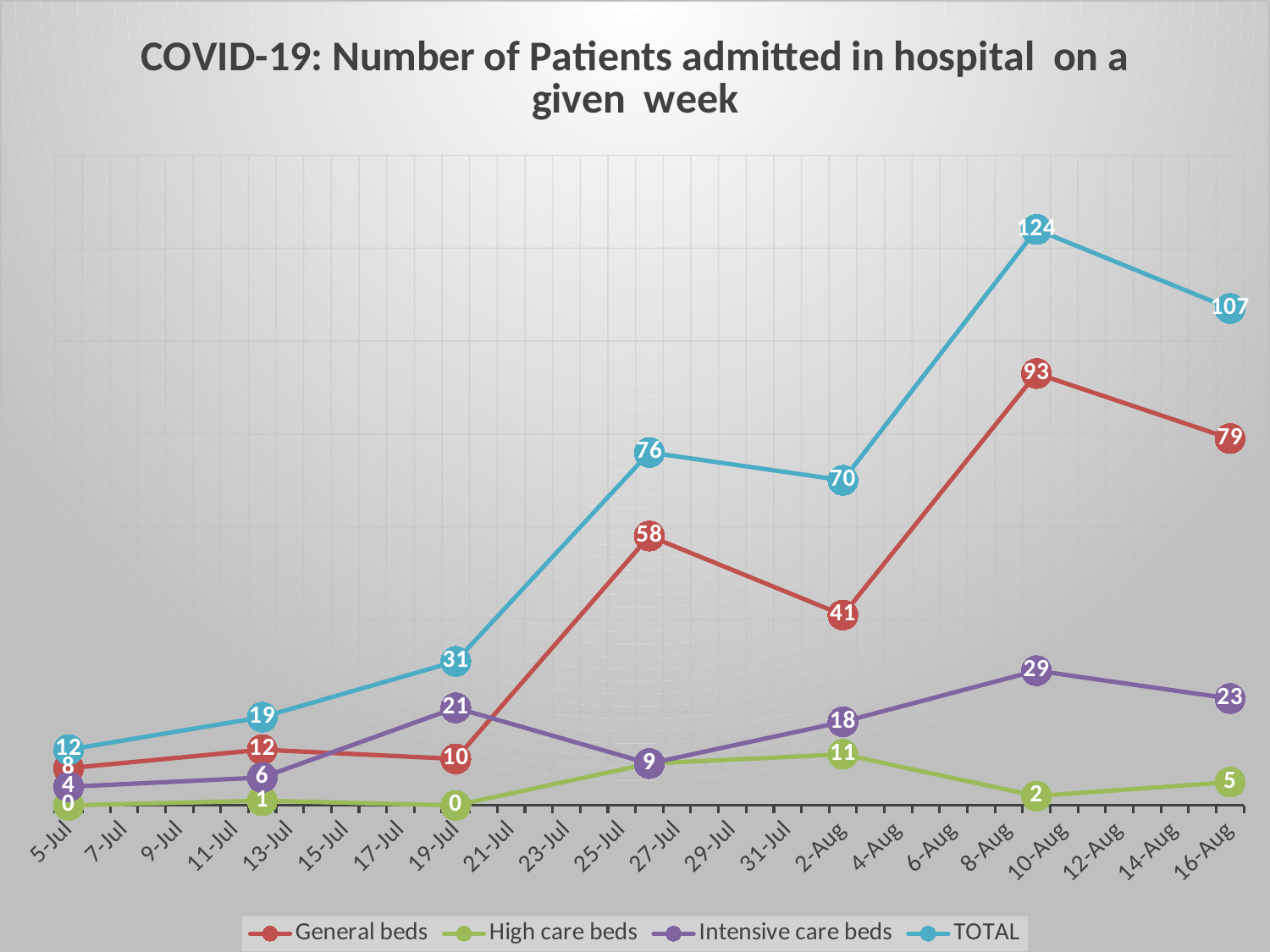
How many data points does the TOTAL series have? 7 What is the difference between the TOTAL value and the General beds value on 16-Aug? 28 On 2-Aug, which is larger: Intensive care beds or High care beds? Intensive care beds What type of chart is shown on the slide? line chart What is the General beds value on 2-Aug? 41 How many series does the legend list? 4 What is the TOTAL value on 16-Aug? 107 What is the lowest TOTAL value shown on the chart? 12 What is the highest TOTAL value shown on the chart? 124 What is the Intensive care beds value on 19-Jul? 21 Does the TOTAL series rise or fall between 5-Jul and 19-Jul? rise What is the High care beds value on 2-Aug? 11